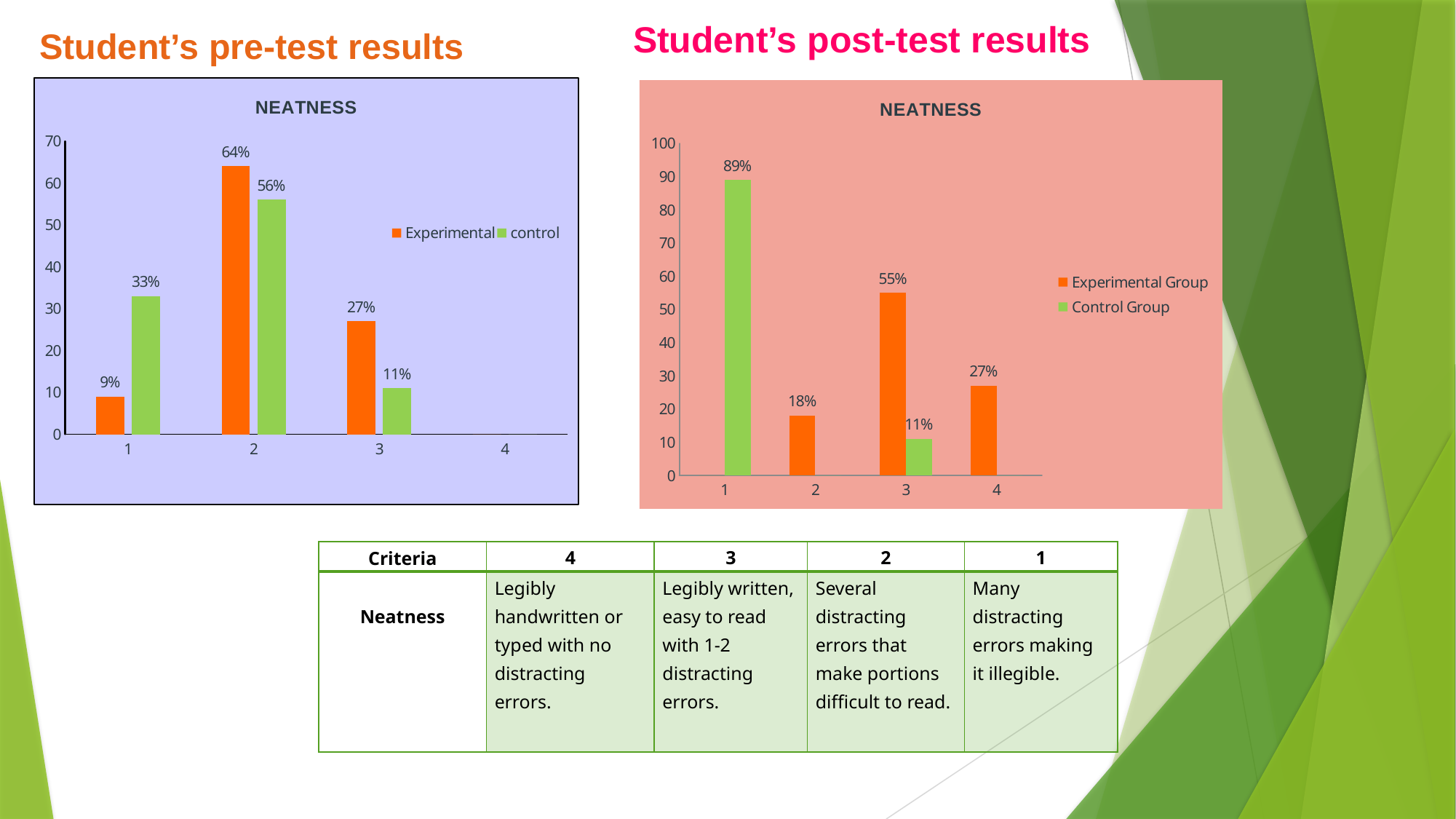
In the post-test results chart, what is the difference between the Experimental Group values at category 3 and category 4? 28% In the post-test results chart, what is the value for the Control Group at category 1? 89% In the pre-test results chart, what is the value for the Experimental series at category 2? 64% In the pre-test results chart, what is the difference between the Experimental and control values at category 3? 16% In the pre-test results chart, which category has the highest Experimental value? 2 In the post-test results chart, what is the value for the Experimental Group at category 3? 55% What is the title shown inside the post-test results chart? NEATNESS In the pre-test results chart, what is the value for the control series at category 1? 33% How many series does the legend of the post-test results chart list? 2 In the pre-test results chart, which is larger at category 1: the Experimental value or the control value? control What kind of chart is the pre-test results chart? bar chart